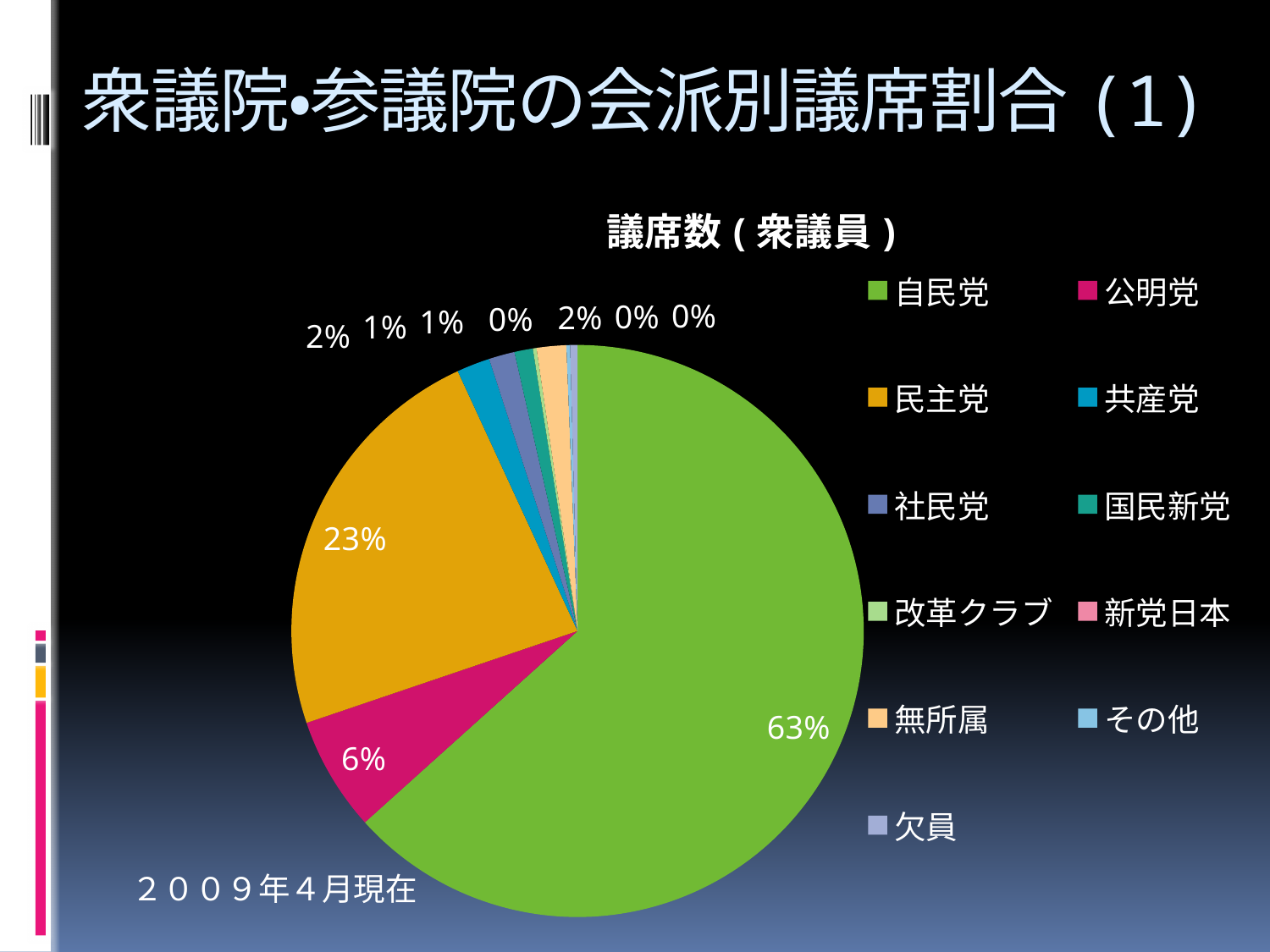
What is the combined share of 自民党, 民主党 and 公明党? 92% How many entries does the legend list? 11 Which has the larger share, 民主党 or 公明党? 民主党 Which party has the largest slice of the pie? 自民党 How many percentage points larger is the 民主党 share than the 公明党 share? 17% What colour is the 自民党 slice? green What share of the pie does 公明党 hold? 6% What share of the pie does 自民党 hold? 63% What is the title of the chart? 議席数（衆議員） What kind of chart is shown on the slide? pie chart How many percentage points larger is the 自民党 share than the 民主党 share? 40% What share of the pie does 民主党 hold? 23%